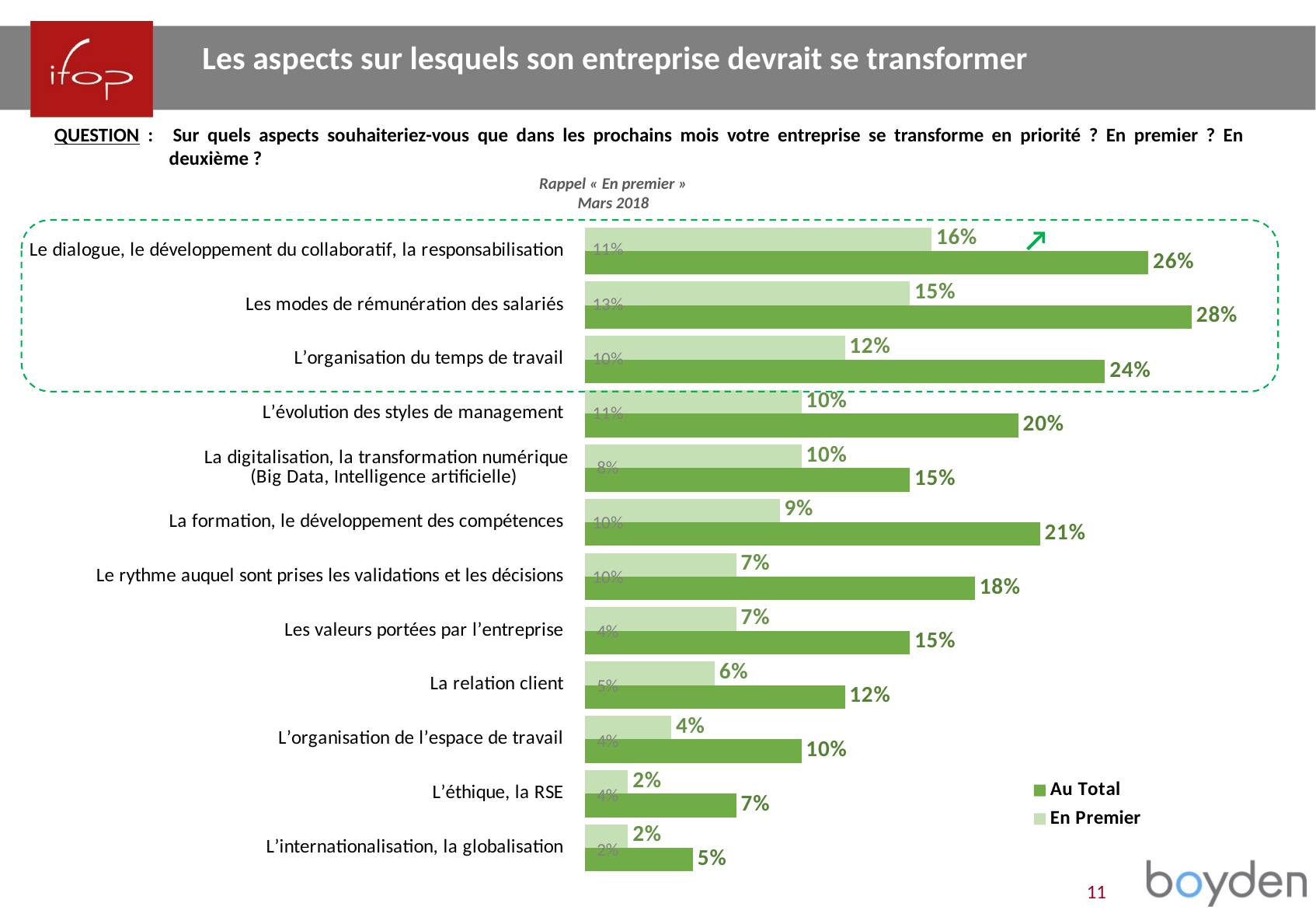
Which category has the lowest "Au Total" value? L'internationalisation, la globalisation Which category has the highest "Au Total" value? Les modes de rémunération des salariés What is the "Au Total" value for "Les modes de rémunération des salariés"? 28% How many categories are shown in the chart? 12 What are the two series named in the legend? Au Total and En Premier What is the "En Premier" value for "Le dialogue, le développement du collaboratif, la responsabilisation"? 16% Which is larger: the "Au Total" value for "Le rythme auquel sont prises les validations et les décisions" or for "Les valeurs portées par l'entreprise"? Le rythme auquel sont prises les validations et les décisions What is the "Au Total" value for "La formation, le développement des compétences"? 21% What is the difference between the "Au Total" and "En Premier" values for "L'organisation du temps de travail"? 12% How many series does the legend list? 2 Which category has the highest "En Premier" value? Le dialogue, le développement du collaboratif, la responsabilisation What kind of chart is shown on the slide? Bar chart